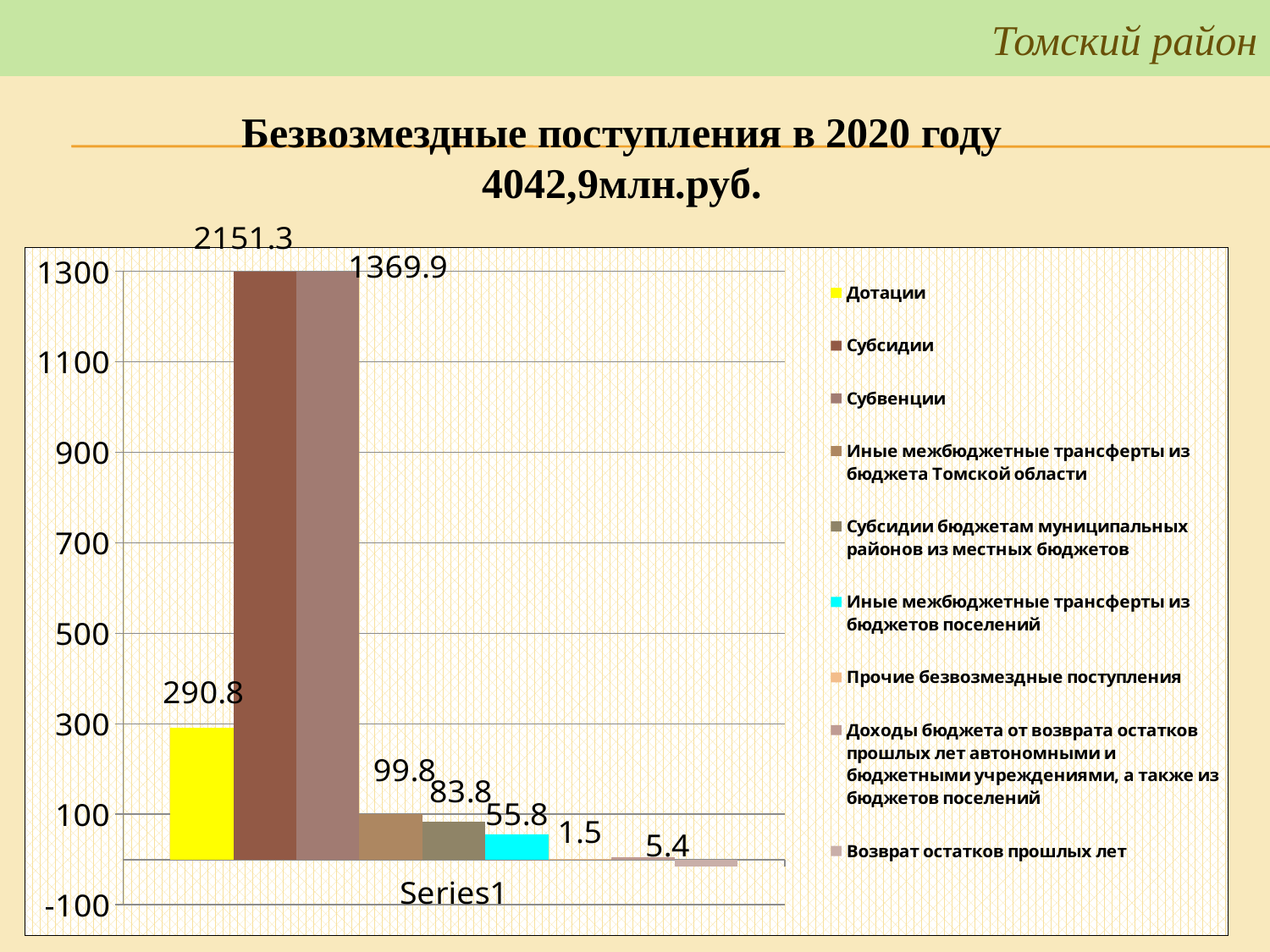
What is the value for Дотации? 290.8 What is the value for Иные межбюджетные трансферты из бюджетов поселений? 55.8 What is the value for Прочие безвозмездные поступления? 1.5 What is the value for Субсидии бюджетам муниципальных районов из местных бюджетов? 83.8 Which is larger, the value for Дотации or the value for Субвенции? Субвенции How many series does the legend list? 9 What is the value for Субсидии? 2151.3 What is the value for Иные межбюджетные трансферты из бюджета Томской области? 99.8 What kind of chart is shown on the slide? Bar chart What is the difference between the values for Субсидии and Субвенции? 781.4 What is the value for Субвенции? 1369.9 Which series has the highest value? Субсидии